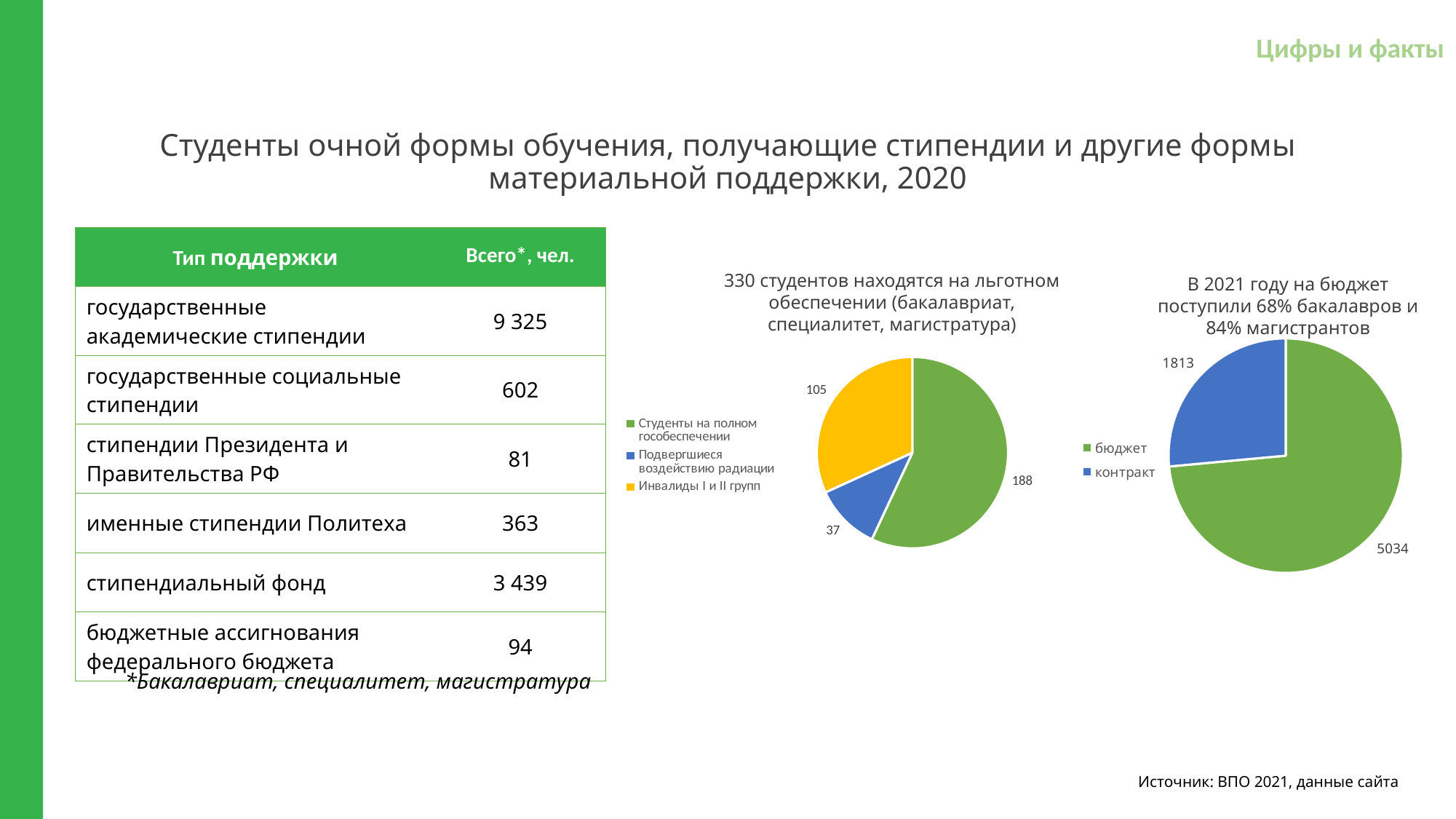
In the right pie chart (В 2021 году на бюджет поступили...), what is the difference between бюджет and контракт? 3221 In the left pie chart (330 студентов находятся на льготном обеспечении), which category has the smallest value? Подвергшиеся воздействию радиации In the right pie chart (В 2021 году на бюджет поступили...), what is the total of all slices? 6847 How many categories does the legend of the left pie chart (330 студентов находятся на льготном обеспечении) list? 3 In the right pie chart (В 2021 году на бюджет поступили...), what is the value for бюджет? 5034 In the left pie chart (330 студентов находятся на льготном обеспечении), what is the value for Подвергшиеся воздействию радиации? 37 What type of chart is the right chart (В 2021 году на бюджет поступили...)? Pie chart In the left pie chart (330 студентов находятся на льготном обеспечении), what is the value for Инвалиды I и II групп? 105 In the left pie chart (330 студентов находятся на льготном обеспечении), what is the difference between Студенты на полном гособеспечении and Инвалиды I и II групп? 83 In the left pie chart (330 студентов находятся на льготном обеспечении), which category has the largest value? Студенты на полном гособеспечении In the left pie chart (330 студентов находятся на льготном обеспечении), what is the value for Студенты на полном гособеспечении? 188 In the right pie chart (В 2021 году на бюджет поступили...), what is the value for контракт? 1813